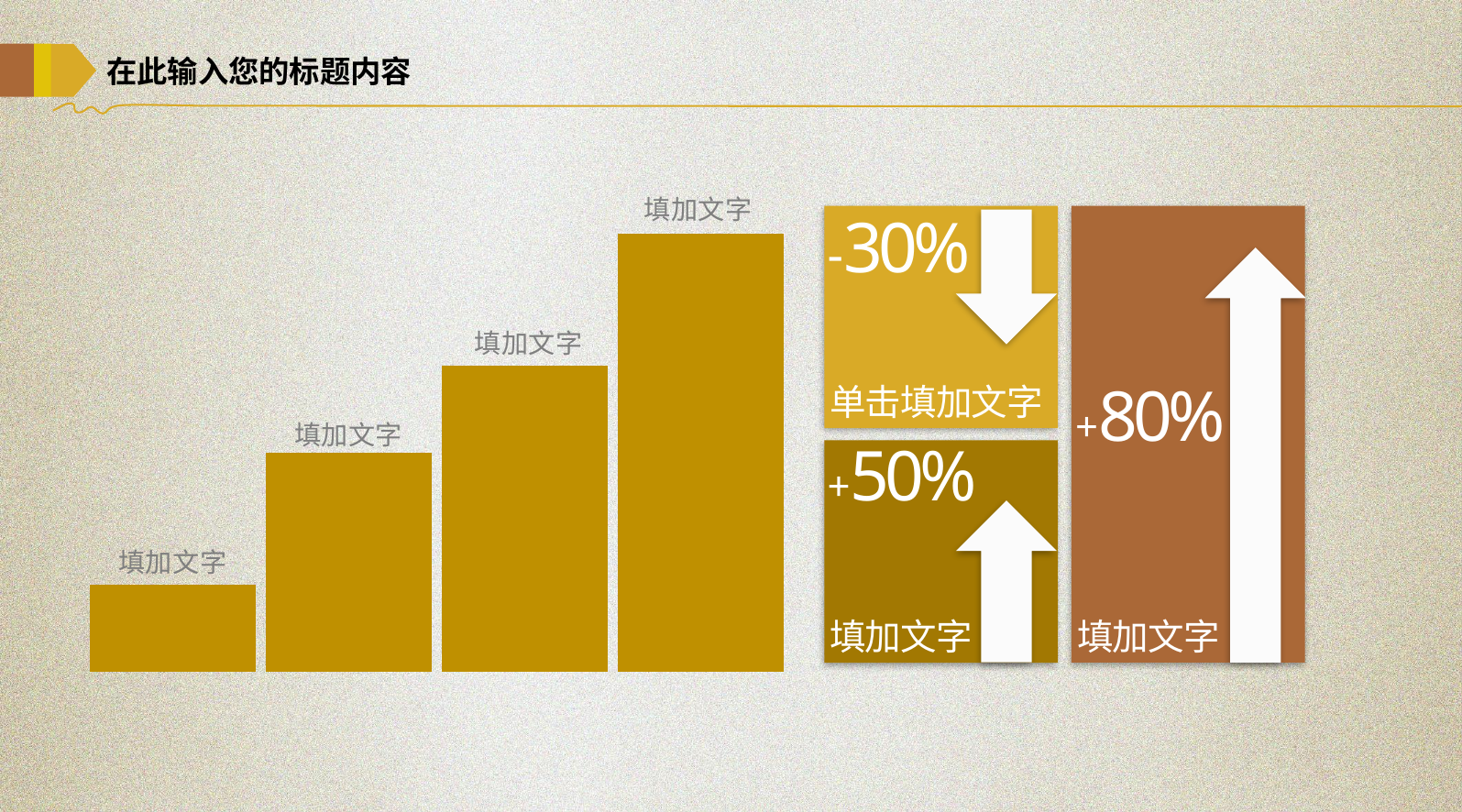
What colour are the bars in the chart on the left of the slide? gold Which bar in the chart on the left is the shortest: the leftmost or the rightmost? the leftmost What label appears above each bar in the chart on the left? 填加文字 What kind of chart is shown on the left of the slide? bar chart Do the bars in the chart on the left rise or fall from left to right? rise Which bar in the chart on the left is the tallest: the leftmost or the rightmost? the rightmost In the chart on the left, is the second bar from the left taller or shorter than the third bar from the left? shorter How many bars does the bar chart on the left of the slide have? 4